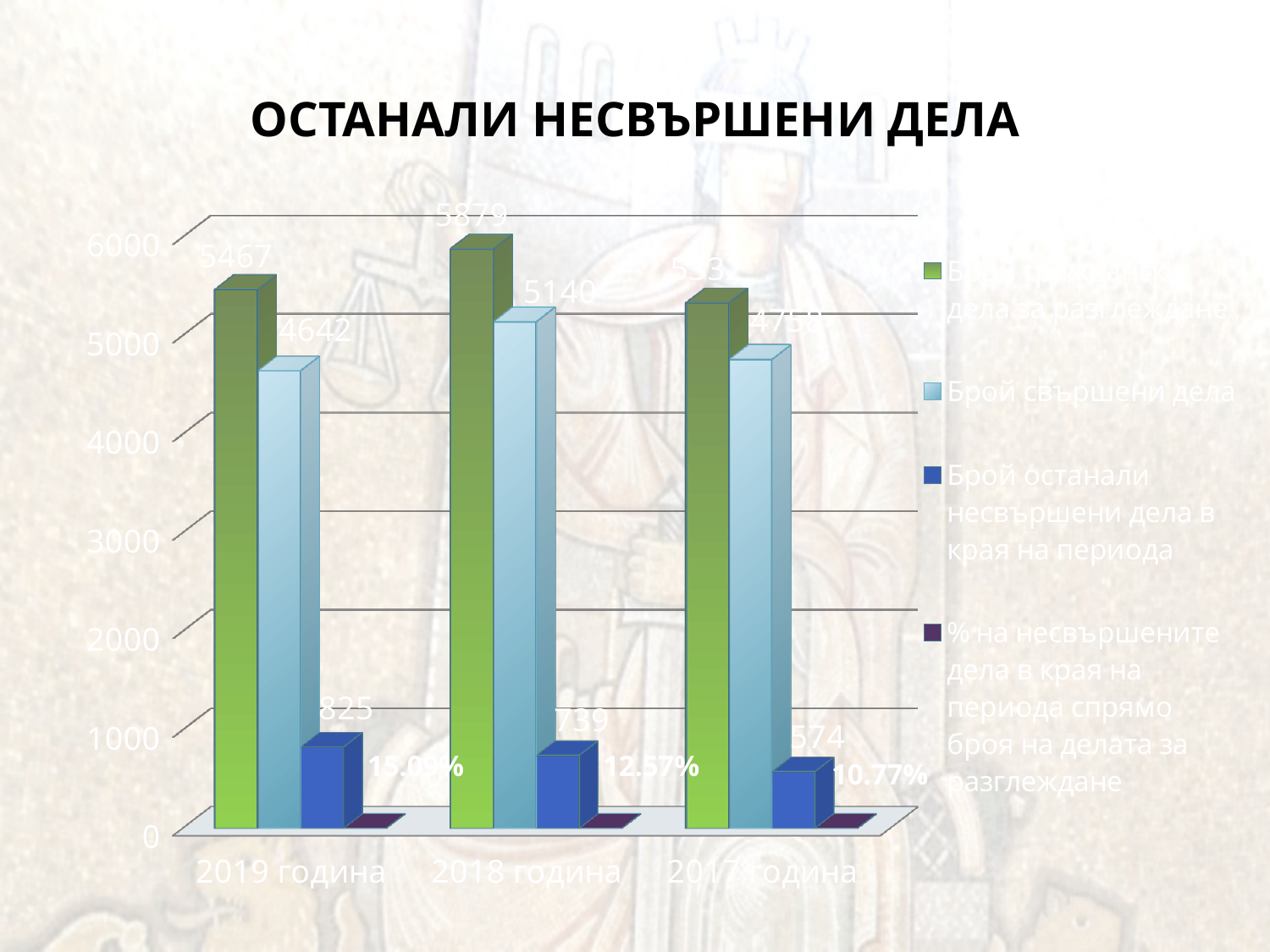
Which is larger: "Брой свършени дела" for 2019 година or for 2018 година? 2018 година What is the difference between "Брой свършени дела" and "Брой останали несвършени дела в края на периода" for 2019 година? 3817 How many year categories are shown on the x axis? 3 How many series does the legend list? 4 For 2018 година, what is the difference between the green bar (5879) and "Брой свършени дела" (5140)? 739 What kind of chart is shown on the slide? bar chart What is the value of "Брой останали несвършени дела в края на периода" for 2018 година? 739 Which year has the lowest value for "Брой останали несвършени дела в края на периода"? 2017 година Which year has the highest value for "Брой свършени дела"? 2018 година Is the value of the green bar for 2017 година greater or less than 5000? greater What percentage is shown for "% на несвършените дела в края на периода спрямо броя на делата за разглеждане" for 2017 година? 10.77% What is the value of "Брой свършени дела" for 2019 година? 4642